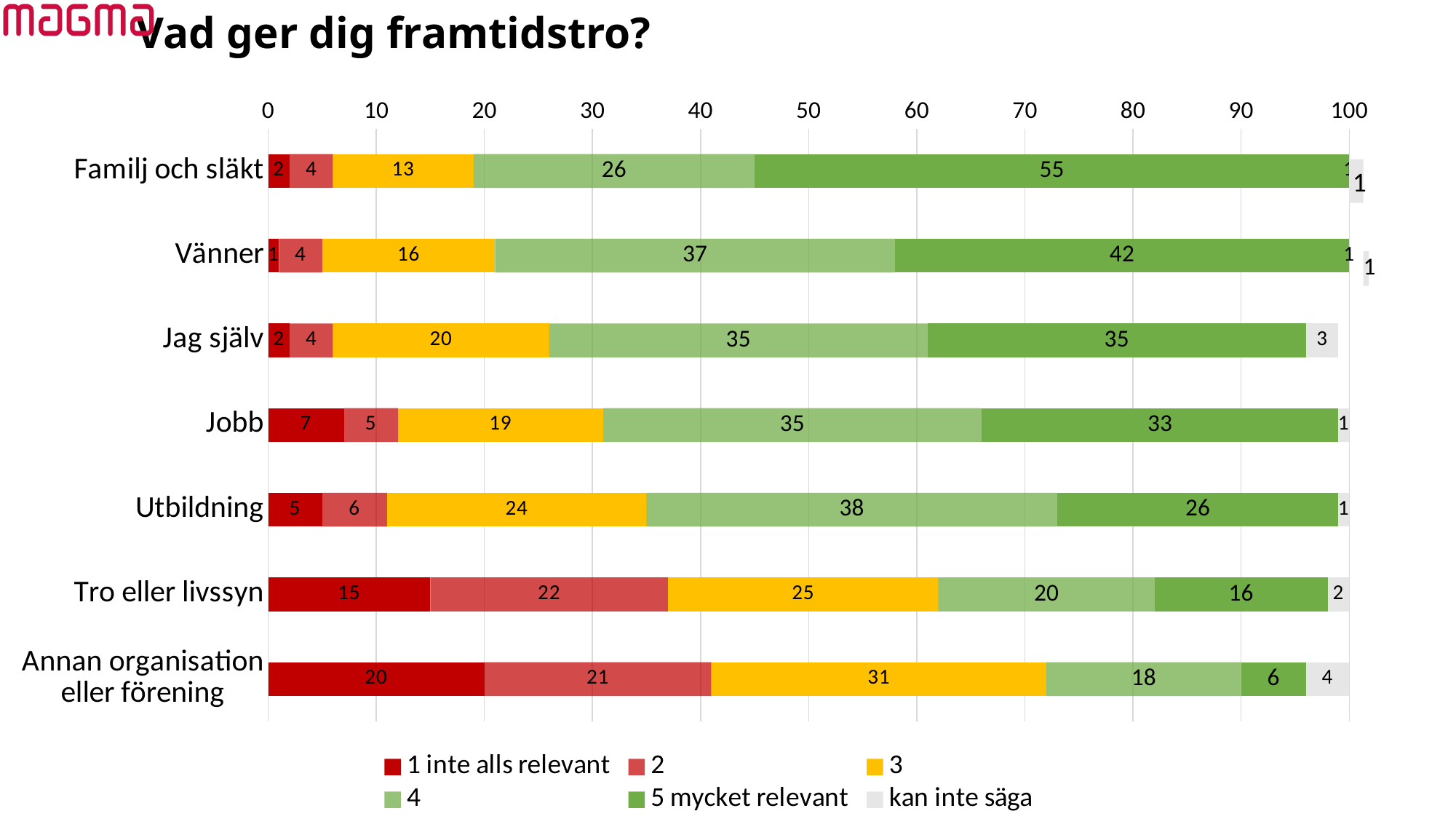
What is the title of the chart? Vad ger dig framtidstro? What is the difference between the '5 mycket relevant' values for Familj och släkt and Vänner? 13 How many categories are shown on the chart? 7 How many series does the legend list? 6 Which is larger: the '1 inte alls relevant' value for Jobb or for Utbildning? Jobb What is the value of '4' for Utbildning? 38 What kind of chart is shown on the slide? stacked bar chart What is the value of '3' for Annan organisation eller förening? 31 Which category has the lowest value for '5 mycket relevant'? Annan organisation eller förening Which category has the highest value for '5 mycket relevant'? Familj och släkt What is the value of '5 mycket relevant' for Familj och släkt? 55 What is the value of '1 inte alls relevant' for Tro eller livssyn? 15